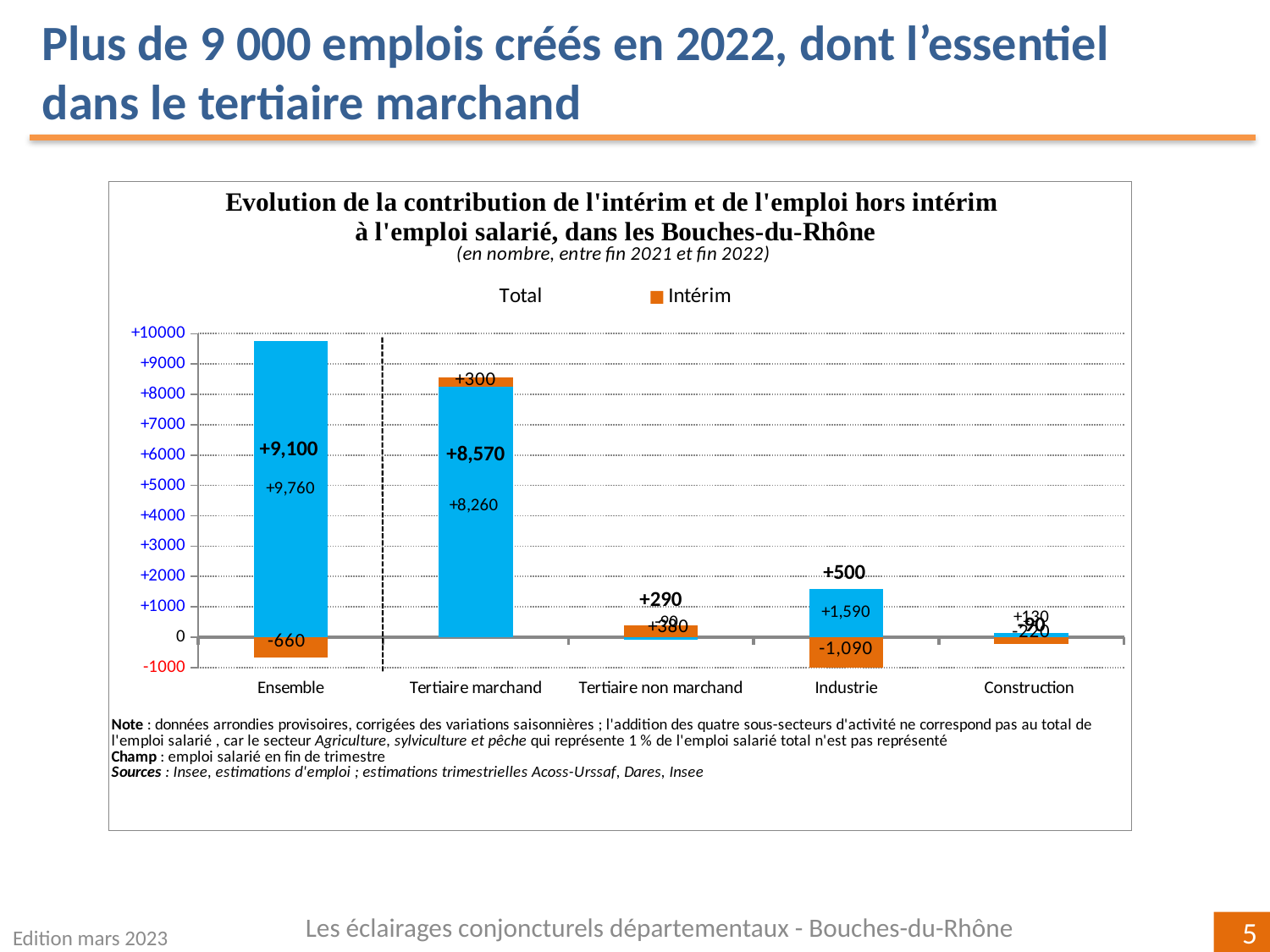
What is the total value shown for Tertiaire marchand? +8,570 Is the blue bar for Ensemble greater or less than 9000? greater How many categories are shown on the x axis? 5 What is the Intérim value for Ensemble? -660 What value is printed on the blue bar for Tertiaire marchand? +8,260 What is the Intérim value for Tertiaire marchand? +300 What is the total value shown for Ensemble? +9,100 What is the Intérim value for Industrie? -1,090 What kind of chart is this? bar chart What is the difference between the total for Ensemble (+9,100) and the total for Tertiaire marchand (+8,570)? 530 Which category has the highest total value? Ensemble What is the total value shown for Industrie? +500